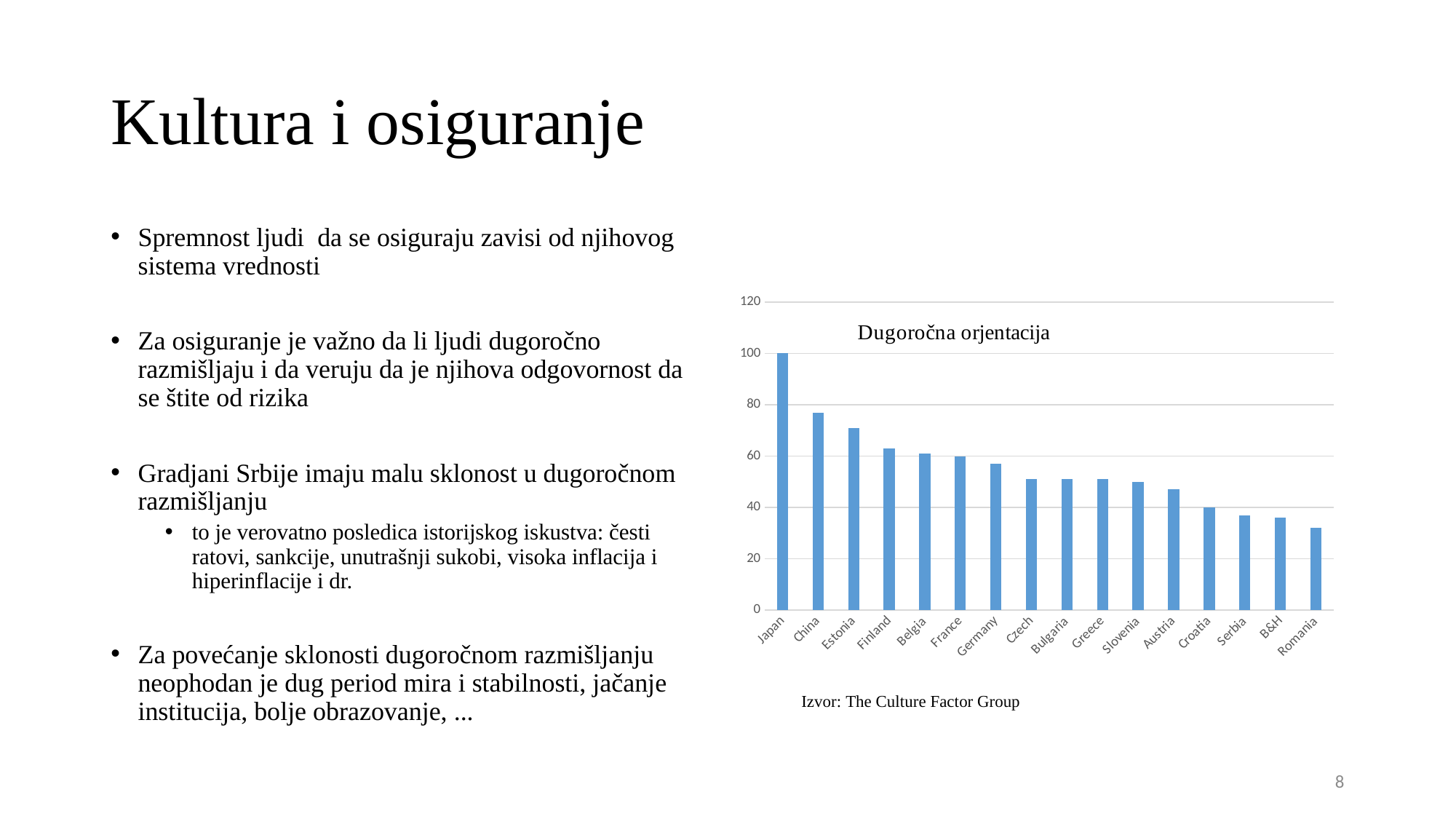
Do the values rise or fall from left to right along the x axis? fall Which country has the highest value in the chart? Japan Is the value for Austria greater or less than 40? greater How many countries are shown in the chart? 16 Which country has the lowest value in the chart? Romania What kind of chart is shown on the slide? bar chart Is the value for China greater or less than 60? greater Which has a larger value, Serbia or Romania? Serbia Is the value for Romania greater or less than 40? less What is the value for Japan? 100 What is the title of the chart? Dugoročna orjentacija